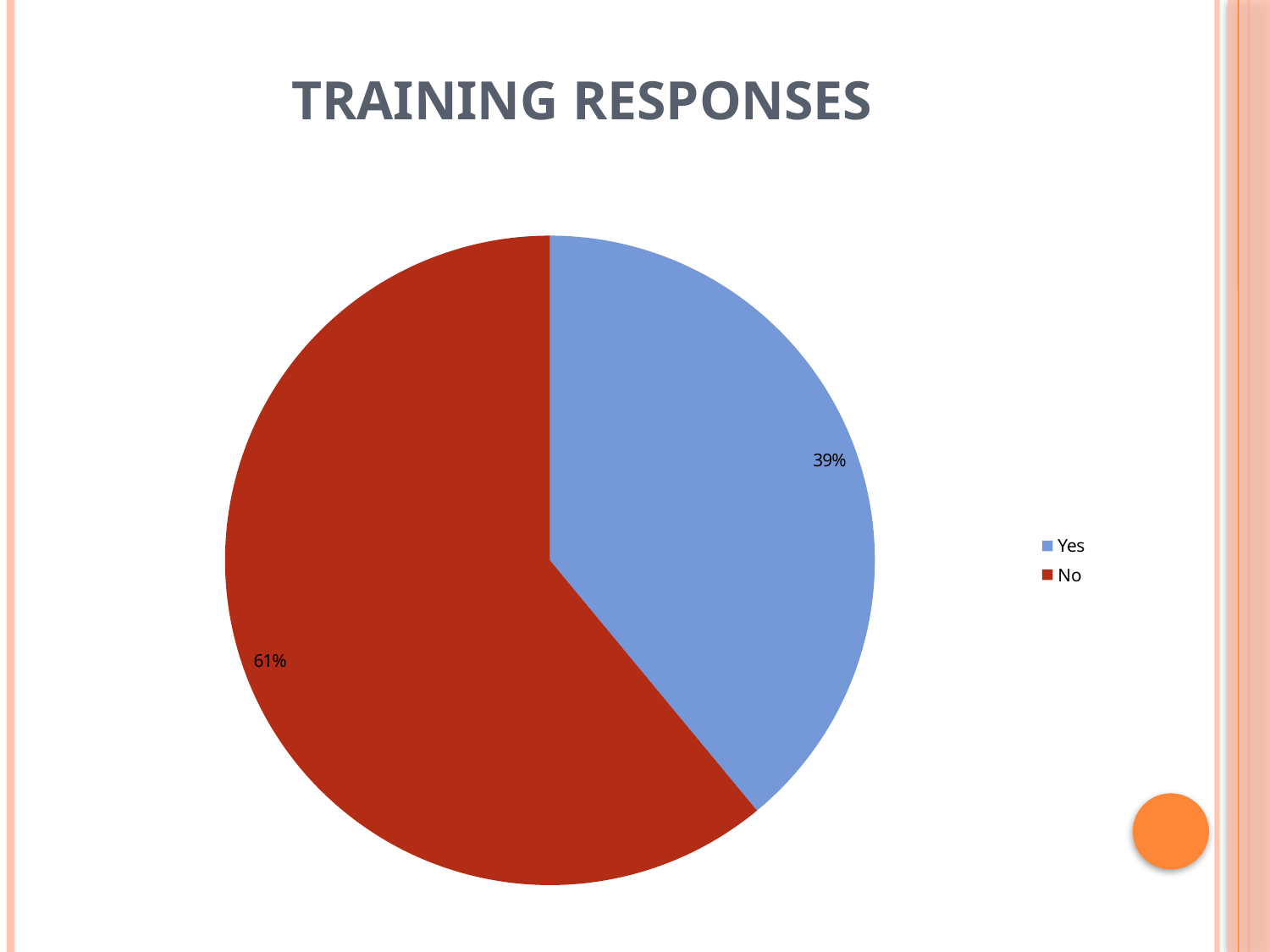
Which category has the largest slice of the pie? No What kind of chart is shown on the slide? Pie chart What colour is the "No" slice in the pie chart? Red Which category has the smallest slice of the pie? Yes What share of the pie does the "Yes" slice represent? 39% Which is larger, the "Yes" slice or the "No" slice? No What is the title of the chart? Training Responses How many categories are shown in the pie chart? 2 What share of the pie does the "No" slice represent? 61% What is the difference in percentage points between the "No" and "Yes" slices? 22